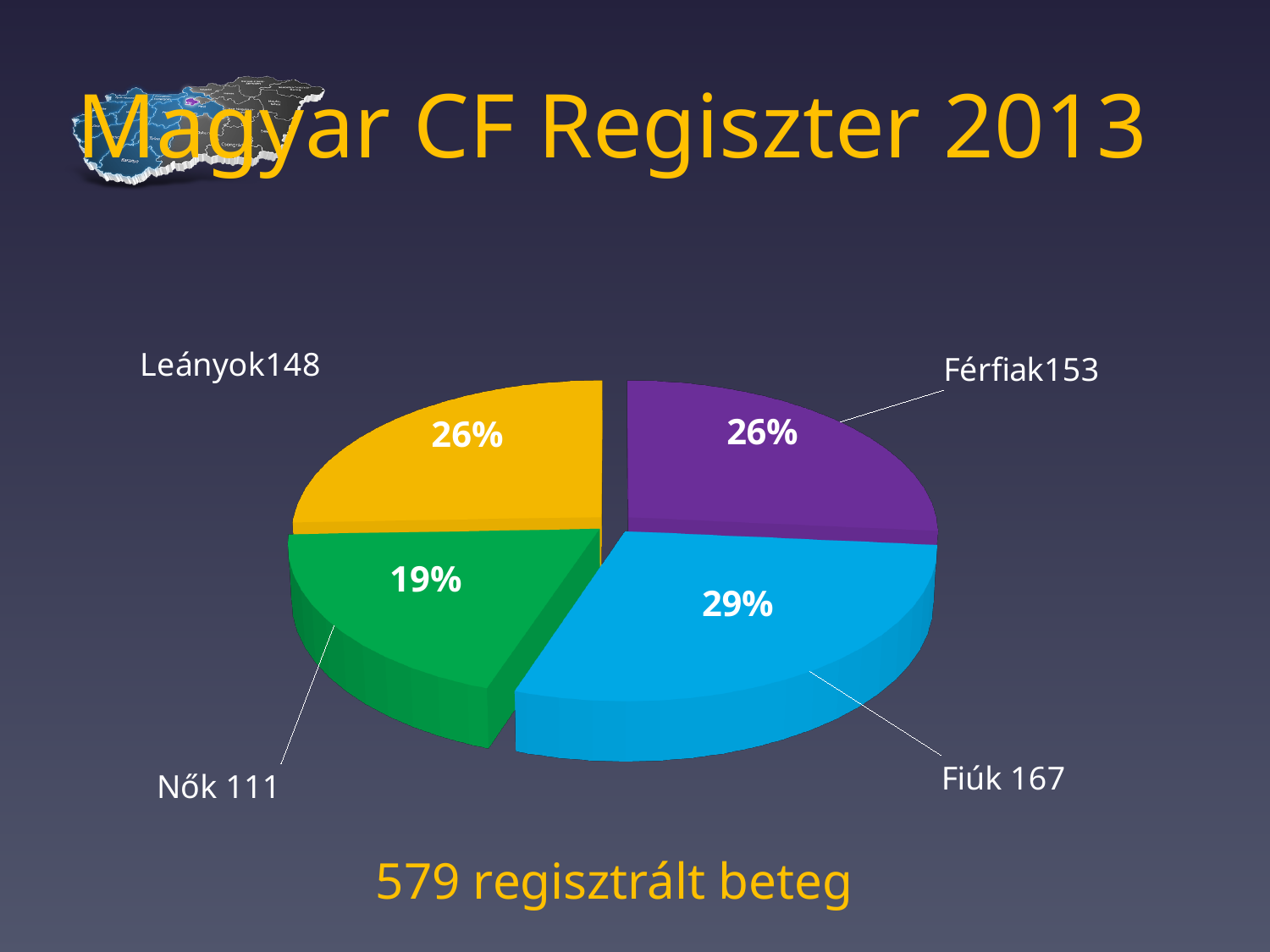
What share of the pie does the Fiúk slice represent? 29% What is the number shown for Férfiak? 153 What share of the pie does the Nők slice represent? 19% What is the number shown for Nők? 111 What colour is the Fiúk slice? blue Which category has the smallest slice of the pie? Nők How many slices does the pie chart have? 4 What kind of chart is shown on the slide? pie chart Which category has the largest slice of the pie? Fiúk What is the difference between the number for Fiúk and the number for Nők? 56 Which has the larger number, Férfiak or Leányok? Férfiak What share of the pie does the Leányok slice represent? 26%